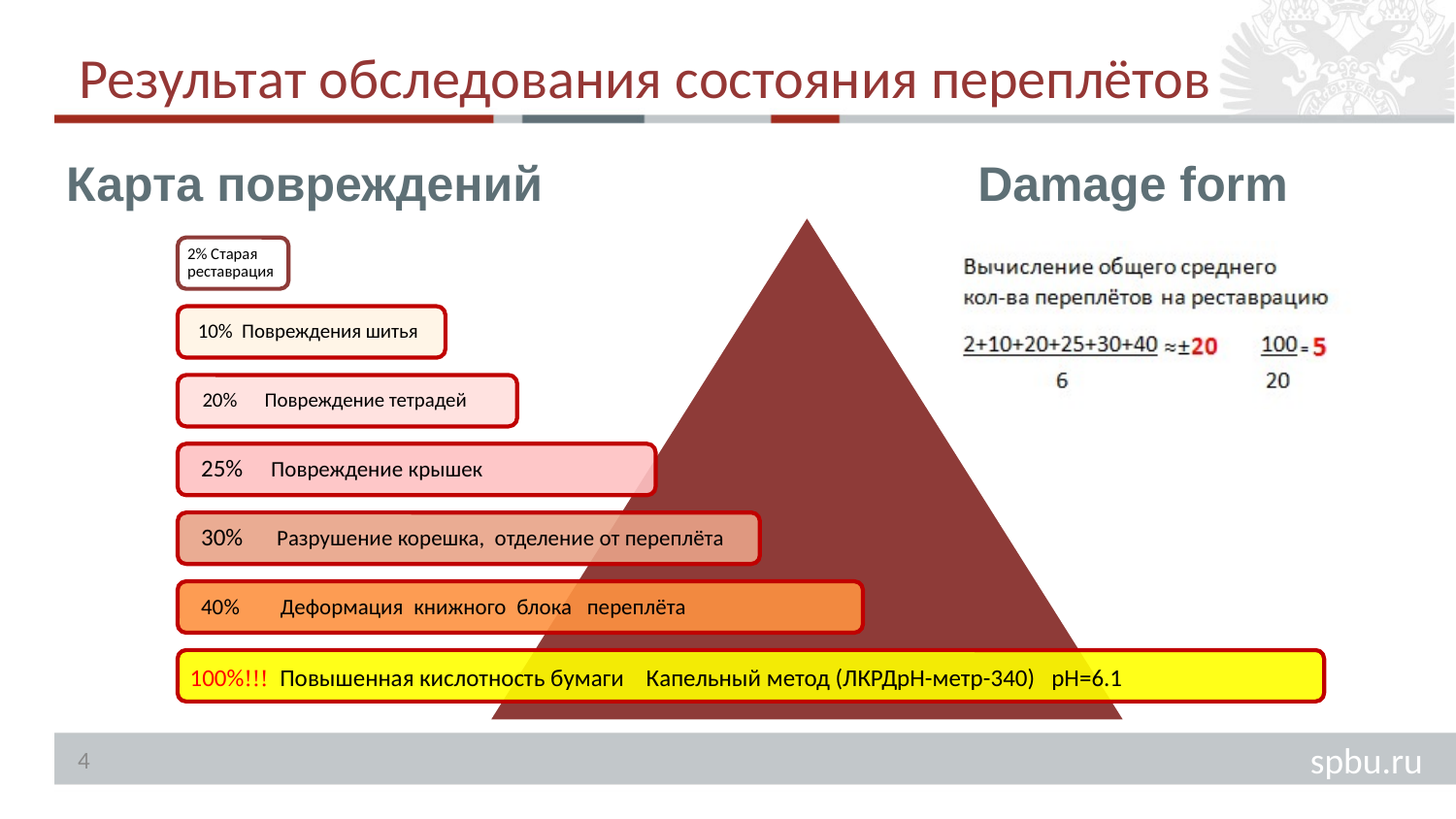
In the 'Карта повреждений' diagram, which damage category has the lowest percentage? Старая реставрация In the 'Карта повреждений' diagram, which damage category has the highest percentage? Повышенная кислотность бумаги In the 'Карта повреждений' diagram, what percentage is shown for 'Разрушение корешка, отделение от переплёта'? 30% In the 'Карта повреждений' diagram, what percentage is shown for 'Деформация книжного блока переплёта'? 40% In the 'Damage form' section, what is the result of dividing 100 by 20? 5 How many damage categories are listed in the 'Карта повреждений' diagram? 7 In the 'Карта повреждений' diagram, what is the difference in percentage between 'Деформация книжного блока переплёта' and 'Повреждение тетрадей'? 20% In the 'Карта повреждений' diagram, what percentage is shown for 'Повреждение крышек'? 25% In the 'Карта повреждений' diagram, what percentage is shown for 'Повреждения шитья'? 10% In the 'Карта повреждений' diagram, which has a higher percentage: 'Повреждение крышек' or 'Повреждение тетрадей'? Повреждение крышек In the 'Карта повреждений' diagram, what pH value is given for 'Повышенная кислотность бумаги'? pH=6.1 In the 'Карта повреждений' diagram, what percentage is shown for 'Старая реставрация'? 2%